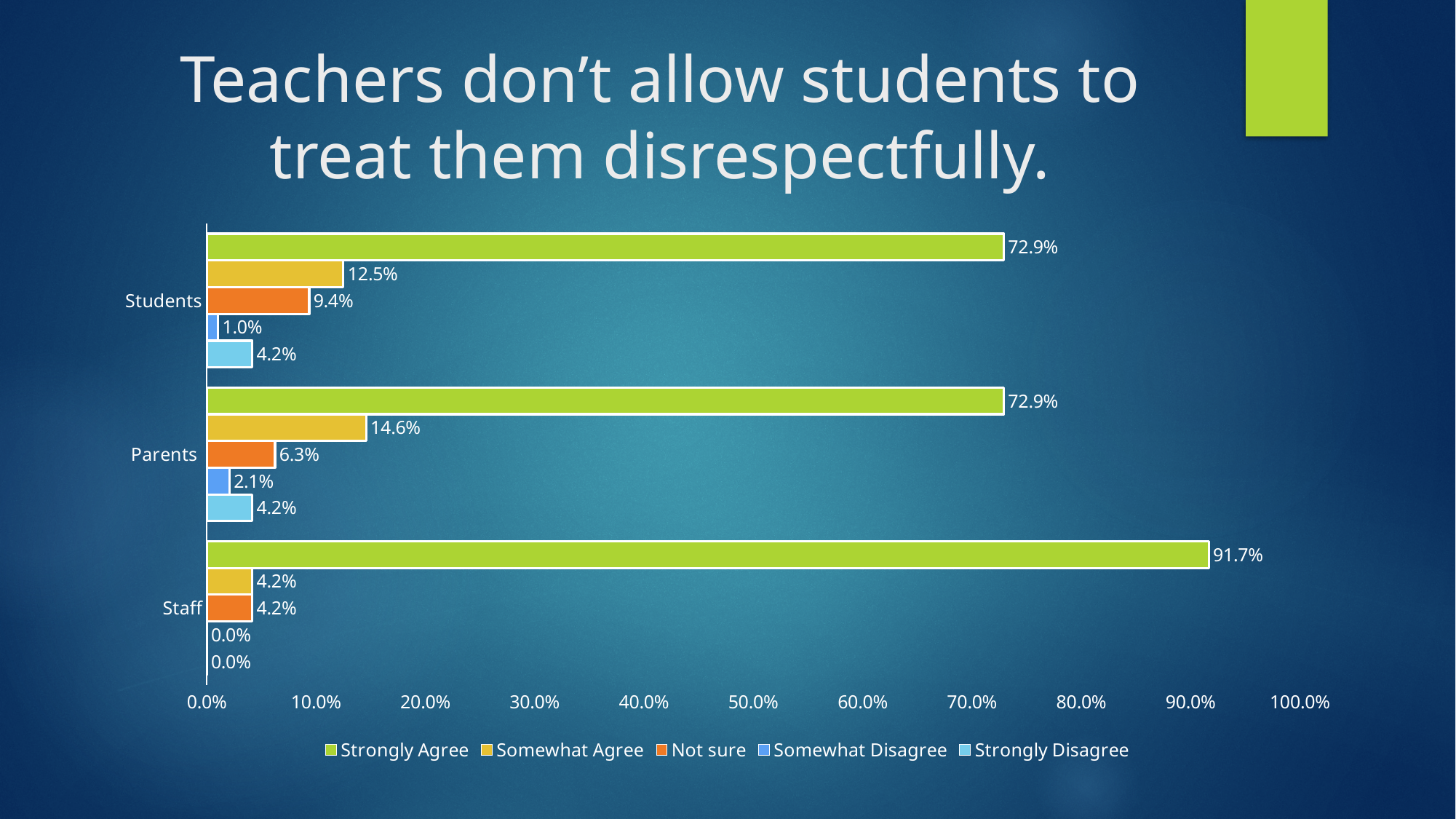
Which is larger, the Not sure value for Students or for Parents? Students Which group has the lowest Somewhat Agree value? Staff Is the Strongly Agree value for Parents greater or less than 70.0%? greater How many series does the legend list? 5 What is the Not sure value for Students? 9.4% What is the Somewhat Disagree value for Parents? 2.1% What is the difference between the Strongly Agree values for Staff and Students? 18.8% What is the Strongly Agree value for Staff? 91.7% Which group has the highest Strongly Agree value? Staff What is the Somewhat Agree value for Parents? 14.6% What kind of chart is shown on the slide? Bar chart How many groups are shown on the vertical axis? 3